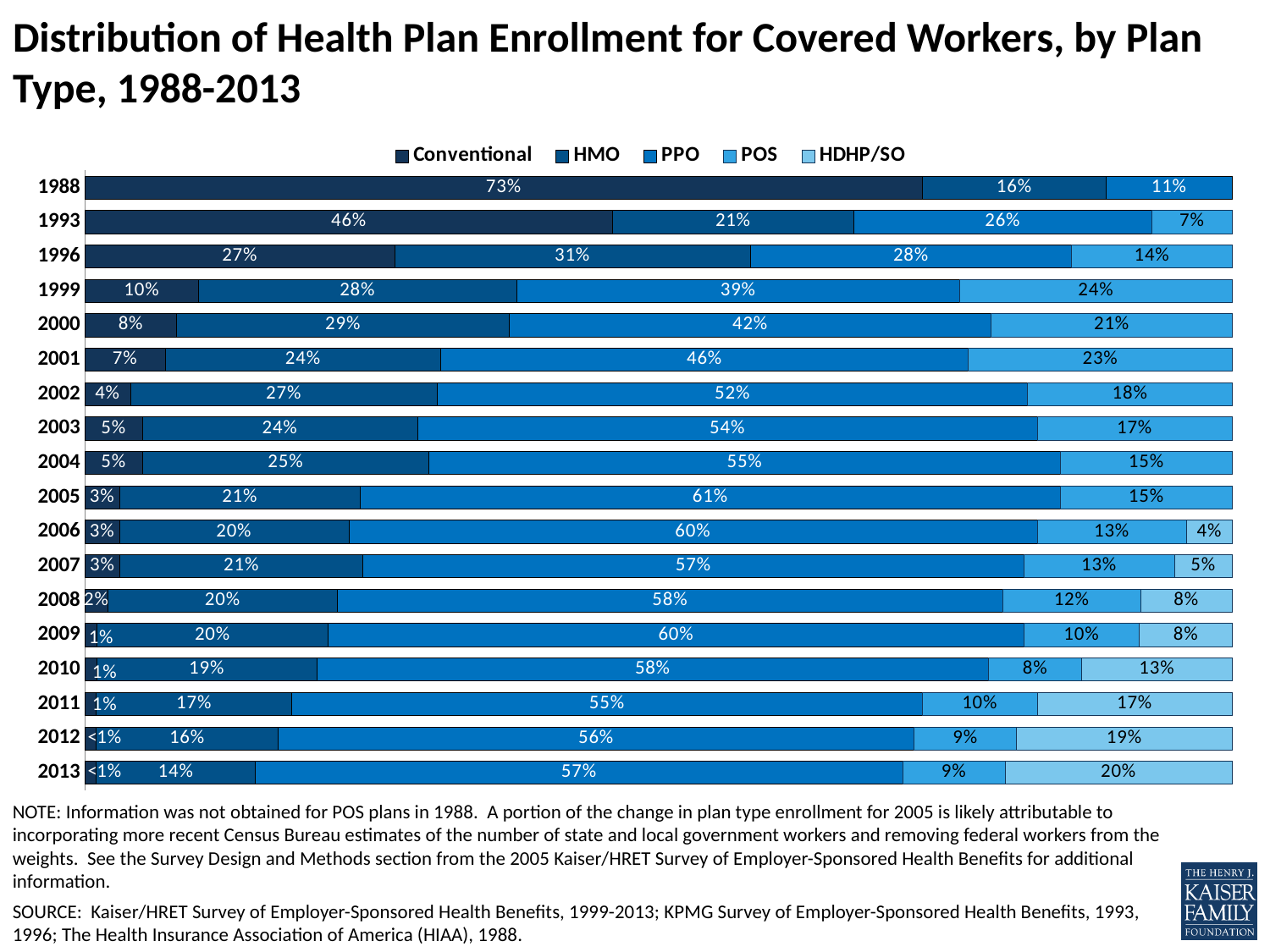
In which year was the PPO enrollment share the highest? 2005 By how many percentage points did the Conventional share fall from 1988 to 1993? 27 percentage points Does the Conventional plan share rise or fall from 1988 to 2013? Fall How many plan types does the legend list? 5 In 2010, which was larger: the POS share or the HDHP/SO share? HDHP/SO What share of covered workers were in HDHP/SO plans in 2013? 20% How many years are shown on the chart? 18 What kind of chart is shown on the slide? Stacked bar chart In which year was the HMO enrollment share the lowest? 2013 What was the Conventional plan enrollment share in 1988? 73% What was the HMO enrollment share in 1996? 31% What percentage of covered workers were enrolled in PPO plans in 2013? 57%